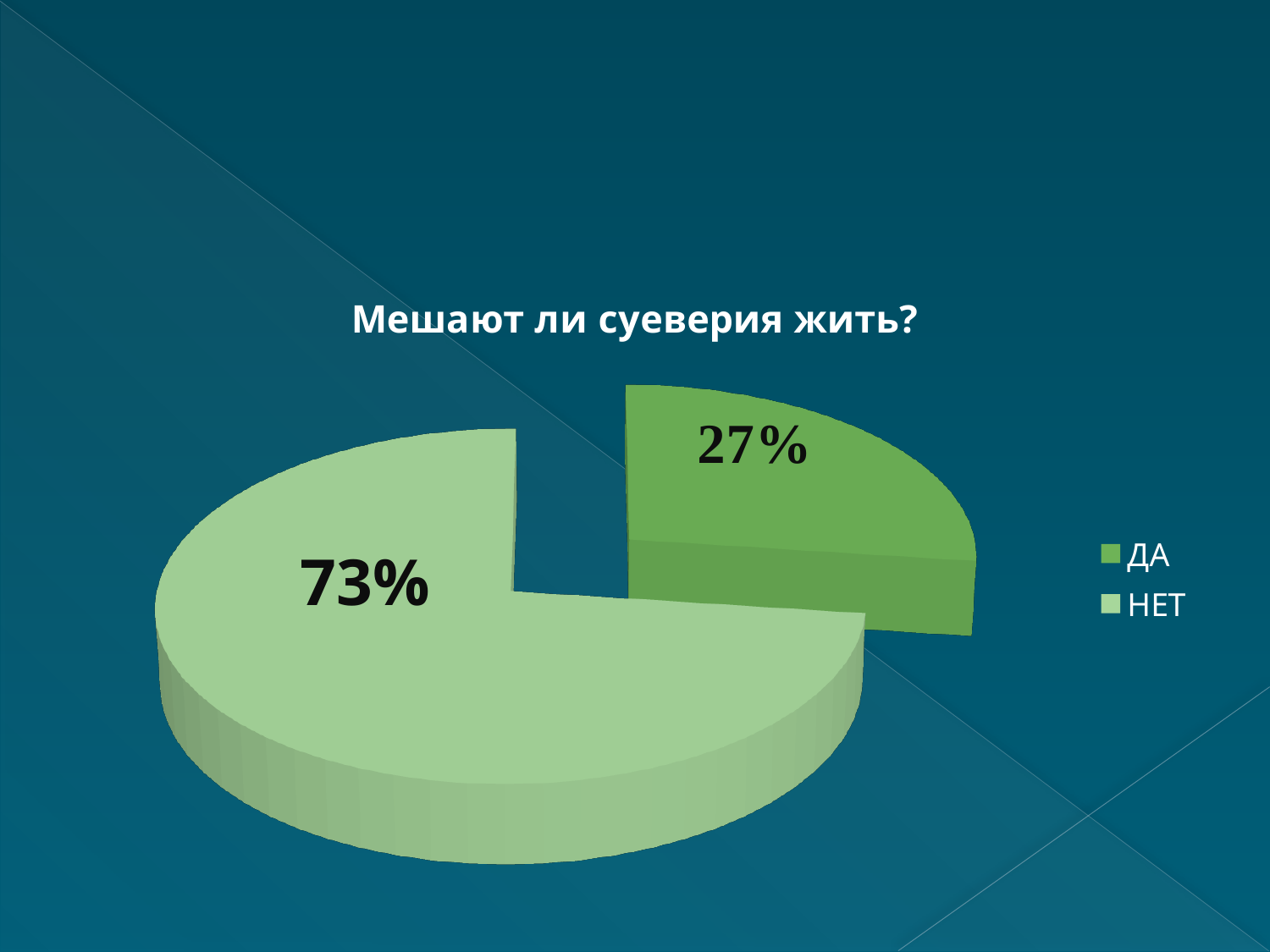
What kind of chart is shown on the slide? pie chart What percentage of the pie is labelled НЕТ? 73% How many slices does the pie chart have? 2 How many entries does the legend list? 2 What is the difference between the НЕТ share and the ДА share? 46% Which slice is pulled out from the rest of the pie? ДА What share of the pie does the ДА slice represent? 27% Which slice is the smallest? ДА Which slice is the largest? НЕТ What percentage of the pie is labelled ДА? 27% What is the title of the chart? Мешают ли суеверия жить? Which is larger, the ДА slice or the НЕТ slice? НЕТ